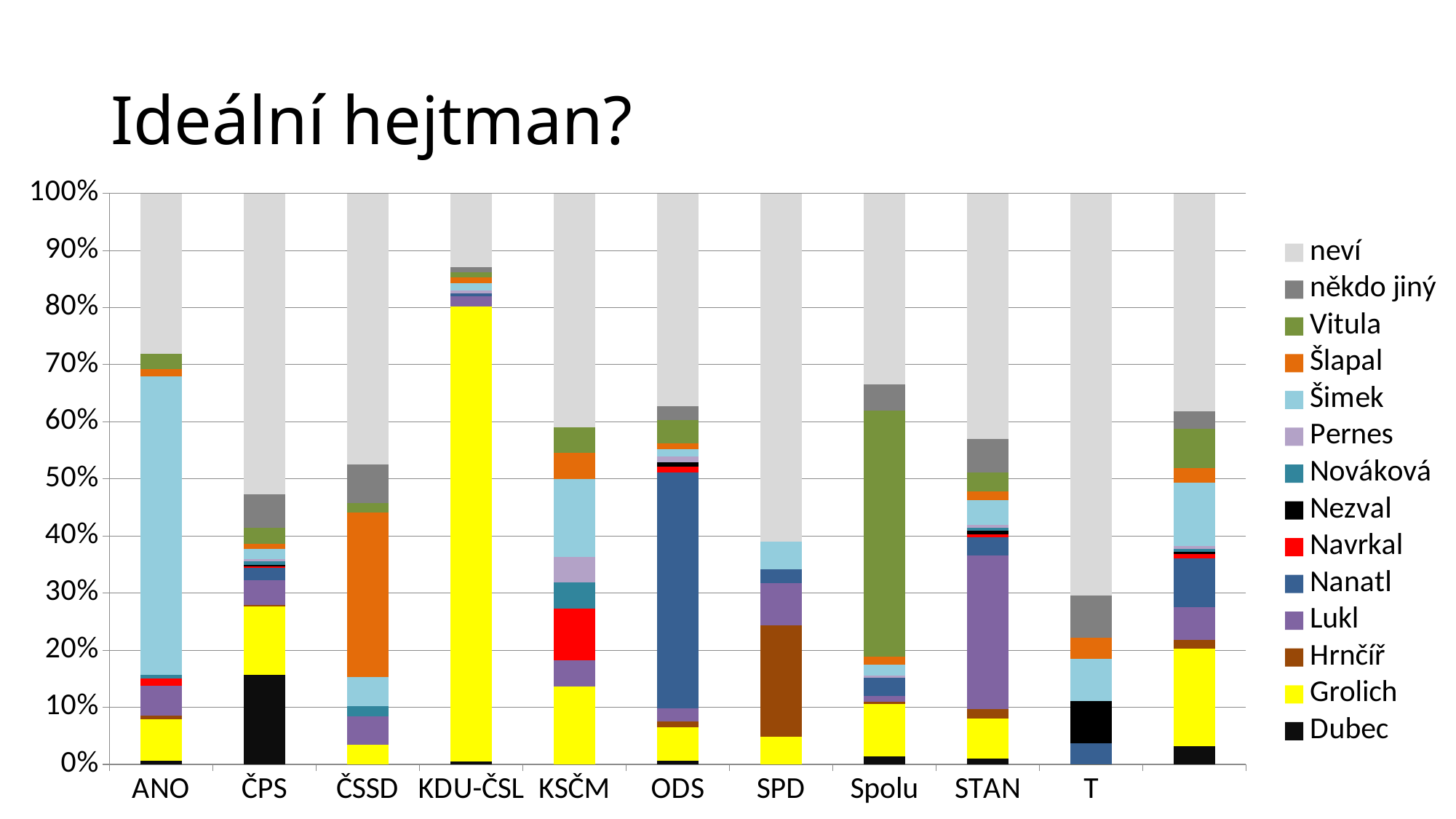
Is the Grolich segment for KDU-ČSL greater or less than 70%? greater Is the Grolich segment larger for ČPS or for ČSSD? ČPS Is the Hrnčíř segment for SPD greater or less than 10%? greater How many bars are plotted in the chart? 11 Is the Šimek segment for ANO greater or less than 40%? greater What is the title of the slide? Ideální hejtman? Which category has the largest neví segment? T Which colour represents Grolich in the legend? yellow What kind of chart is shown on the slide? stacked bar chart Which category has the largest Grolich segment? KDU-ČSL How many series does the legend list? 14